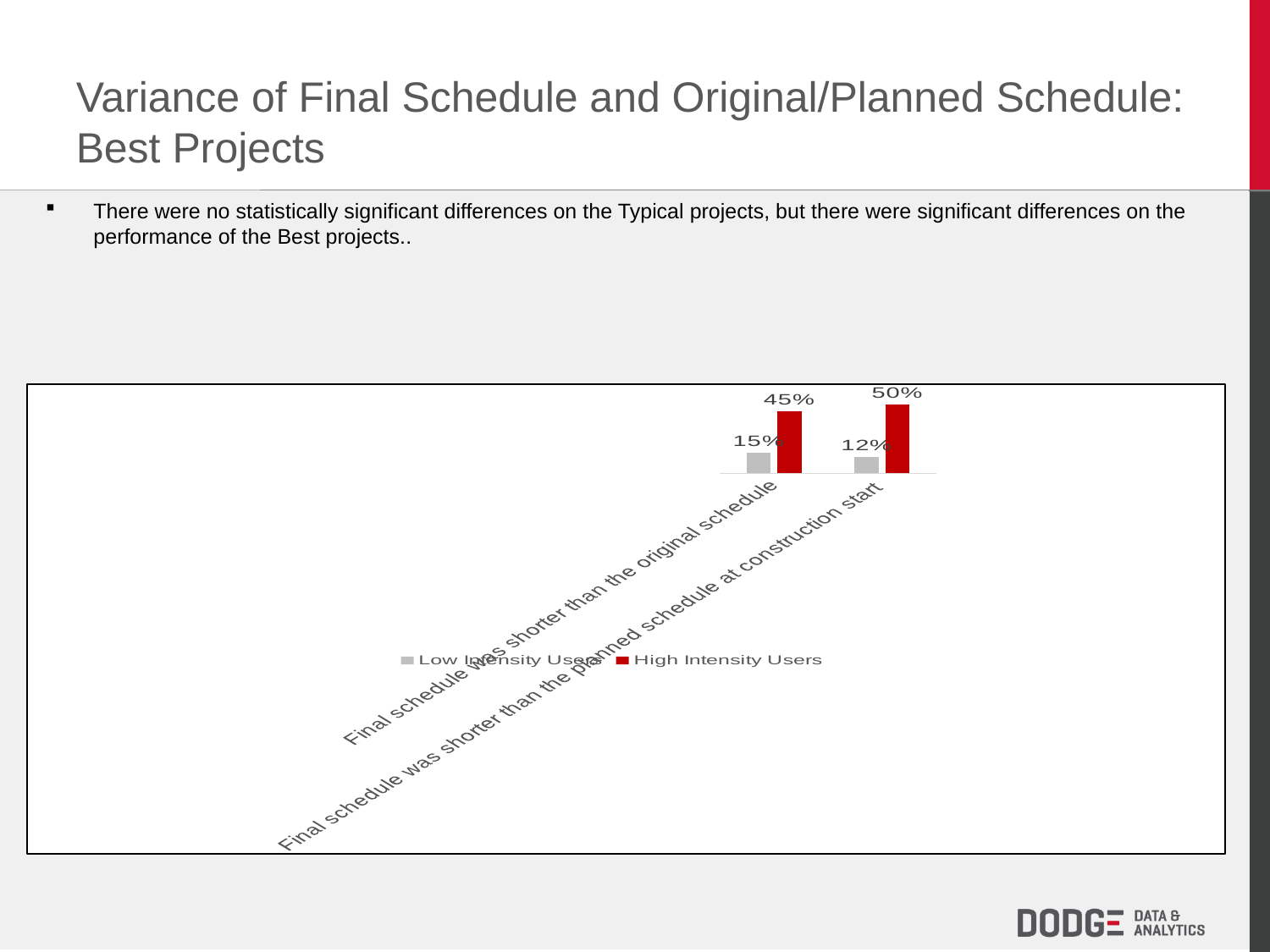
Which category has the lowest value for Low Intensity Users? Final schedule was shorter than the planned schedule at construction start Which series has the higher value for 'Final schedule was shorter than the original schedule'? High Intensity Users What is the difference between High Intensity Users and Low Intensity Users for 'Final schedule was shorter than the planned schedule at construction start'? 38% How many categories are shown on the chart? 2 How many series does the legend list? 2 What kind of chart is shown on the slide? Bar chart What is the difference between High Intensity Users and Low Intensity Users for 'Final schedule was shorter than the original schedule'? 30% What is the value for Low Intensity Users for 'Final schedule was shorter than the planned schedule at construction start'? 12% What is the value for High Intensity Users for 'Final schedule was shorter than the planned schedule at construction start'? 50% What is the value for Low Intensity Users for 'Final schedule was shorter than the original schedule'? 15% What is the value for High Intensity Users for 'Final schedule was shorter than the original schedule'? 45% Which category has the highest value for High Intensity Users? Final schedule was shorter than the planned schedule at construction start